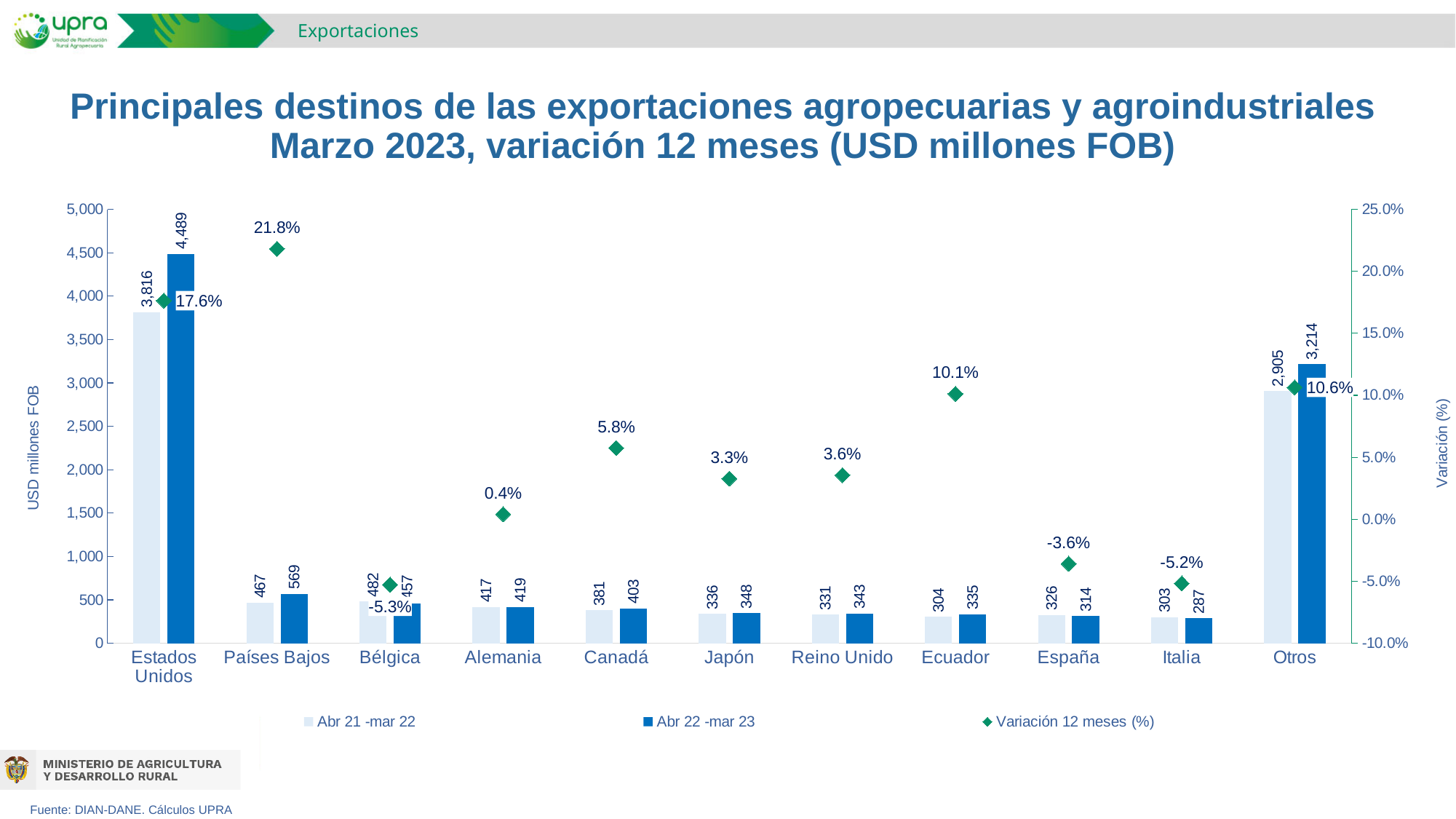
What is the value for Estados Unidos in the Abr 22 -mar 23 series? 4,489 How many destination categories are shown on the x axis? 11 What kind of chart is this? Bar chart with a line/marker series on a secondary axis Which category has the lowest value in the Abr 22 -mar 23 series? Italia Which is larger for Bélgica: the Abr 21 -mar 22 value or the Abr 22 -mar 23 value? Abr 21 -mar 22 What is the difference between the Abr 22 -mar 23 and Abr 21 -mar 22 values for Estados Unidos? 673 What is the Variación 12 meses (%) value for Italia? -5.2% What is the Variación 12 meses (%) value for Países Bajos? 21.8% How many series does the legend list? 3 What is the label of the left vertical axis? USD millones FOB What is the value for Ecuador in the Abr 21 -mar 22 series? 304 Which country has the highest Variación 12 meses (%)? Países Bajos